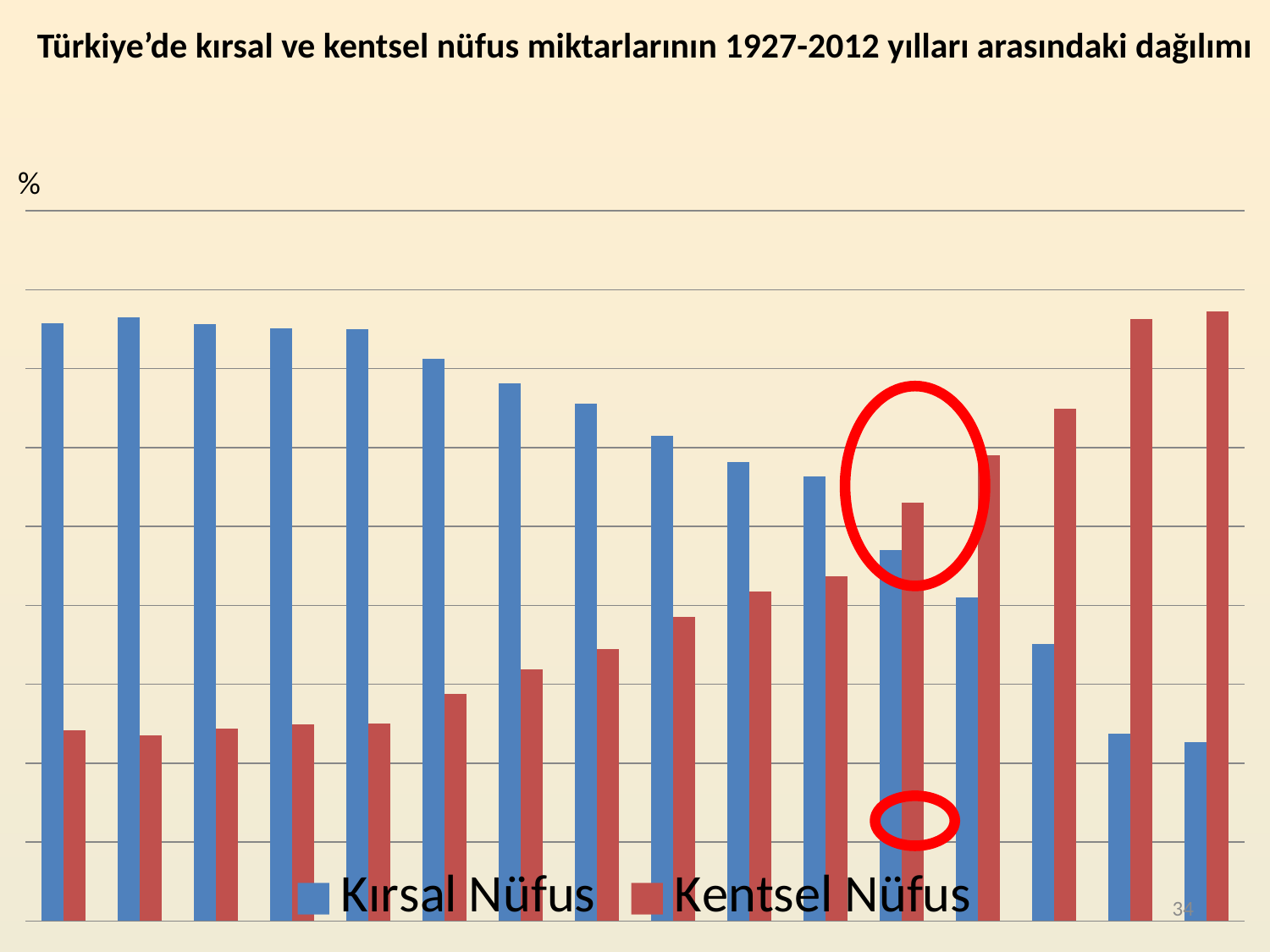
How many series does the legend list? 2 Which series has the shortest bar anywhere in the chart? Kırsal Nüfus How many pairs of bars (categories) are plotted in the chart? 16 Which colour represents Kırsal Nüfus in the chart? blue What are the two series named in the legend? Kırsal Nüfus and Kentsel Nüfus What kind of chart is shown on the slide? bar chart Which series has the tallest bar anywhere in the chart? Kentsel Nüfus In the rightmost pair of bars, which series has the larger value? Kentsel Nüfus In the leftmost pair of bars, which series has the larger value? Kırsal Nüfus What unit is indicated on the vertical axis of the chart? % Does the Kırsal Nüfus series rise or fall from left to right along the x axis? fall Does the Kentsel Nüfus series rise or fall from left to right along the x axis? rise